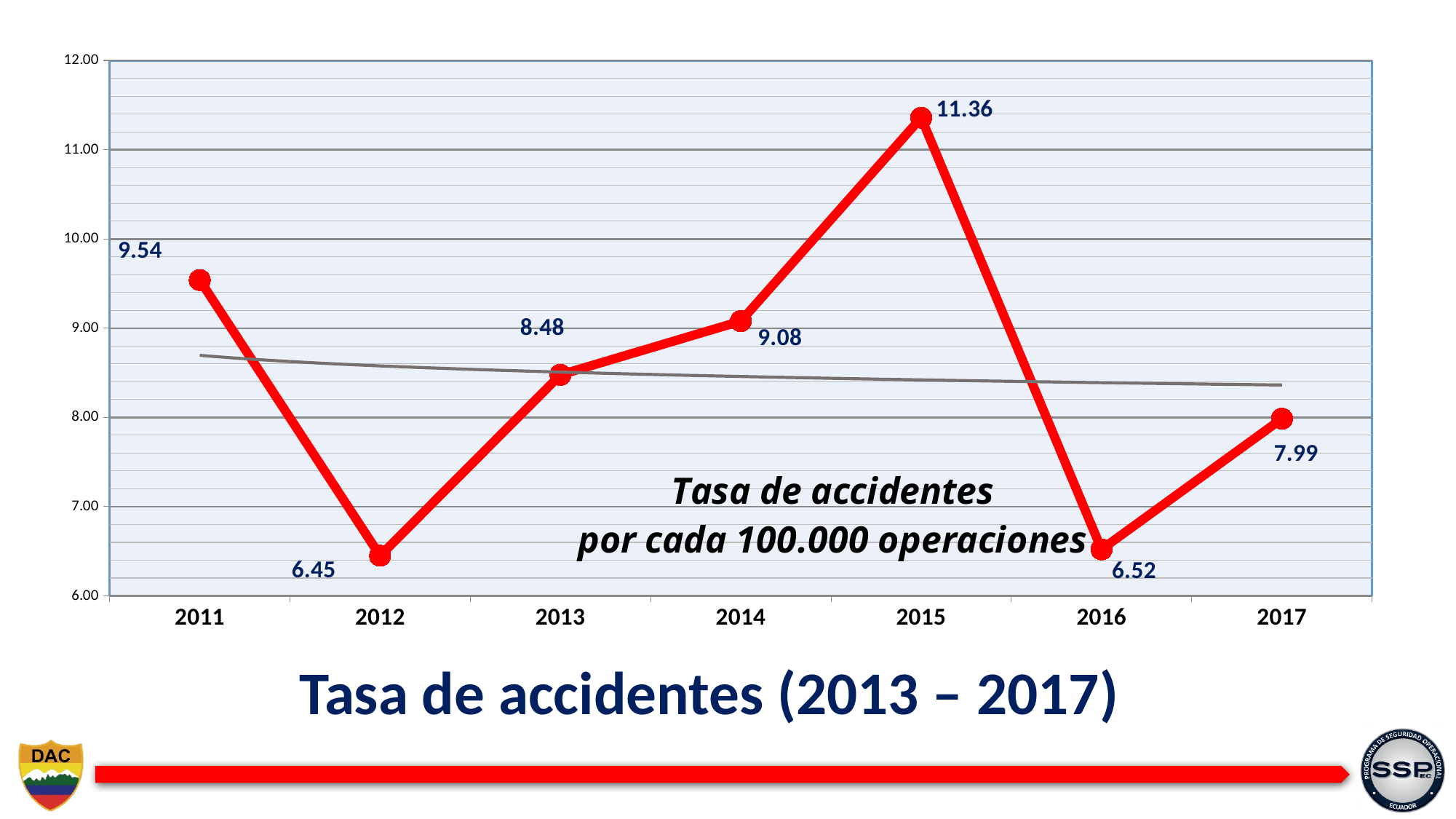
What is the accident rate for 2012? 6.45 Which year has a higher accident rate, 2013 or 2014? 2014 How many years are plotted on the chart? 7 Does the accident rate rise or fall from 2012 to 2015? rise What is the difference between the accident rate in 2011 and in 2012? 3.09 What is the accident rate for 2015? 11.36 Which year has the highest accident rate? 2015 Is the accident rate for 2011 greater or less than 9.00? greater What is the difference between the accident rate in 2015 and in 2016? 4.84 What kind of chart is shown on the slide? line chart Which year has the lowest accident rate? 2012 What is the accident rate for 2017? 7.99